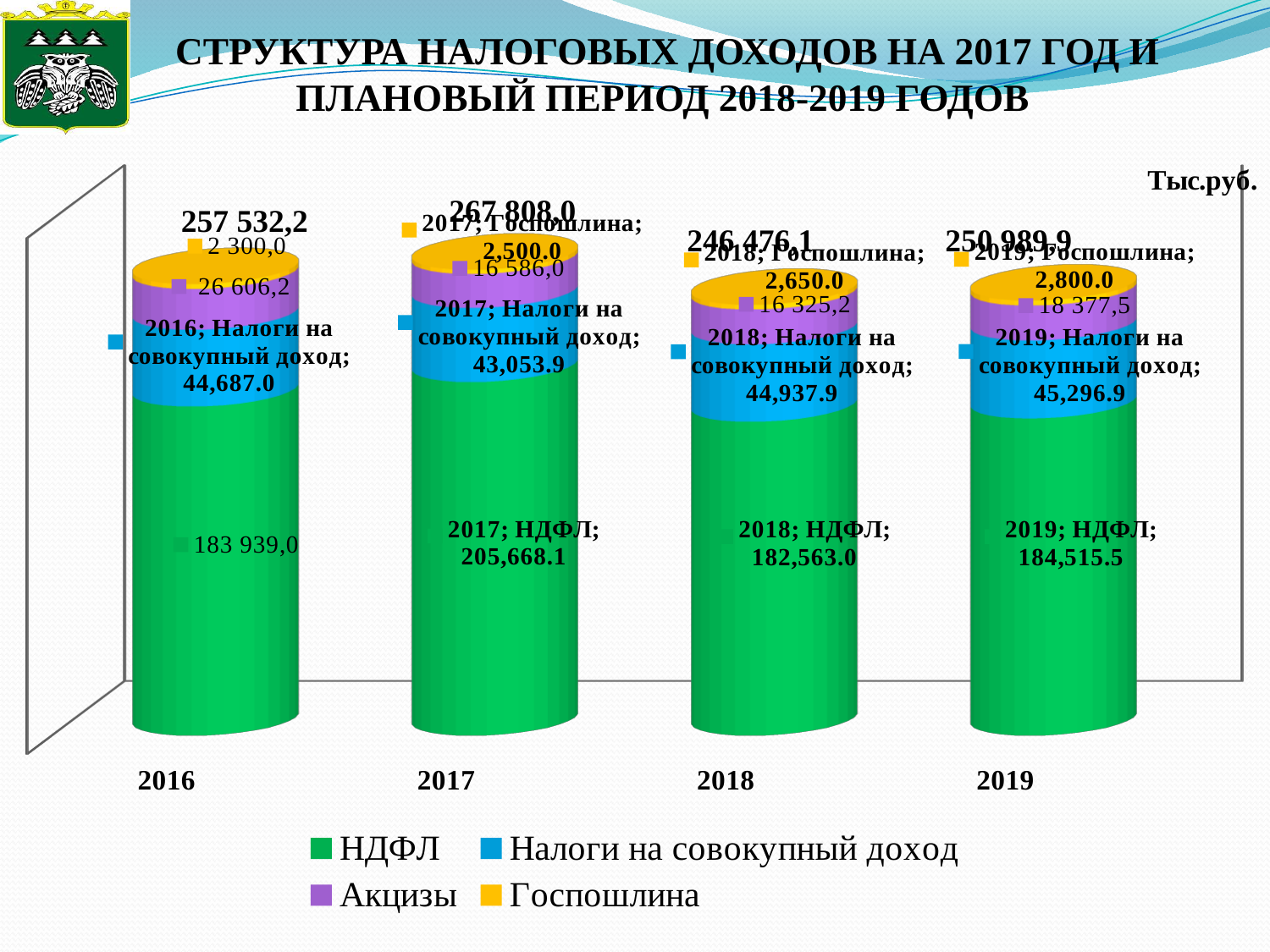
What is the value of Акцизы for 2016? 26 606,2 How many series does the legend list? 4 How many years (categories) are shown on the x axis? 4 What is the total of the stacked bar for 2017? 267 808,0 What is the value of НДФЛ for 2017? 205,668.1 What is the difference between Госпошлина in 2019 and in 2018? 150.0 What type of chart is shown on the slide? Stacked bar chart Which is larger: НДФЛ in 2016 or НДФЛ in 2019? 2019 Which year has the lowest total tax revenue? 2018 What is the value of Госпошлина for 2018? 2,650.0 Which year has the highest total tax revenue? 2017 What is the value of Налоги на совокупный доход for 2019? 45,296.9